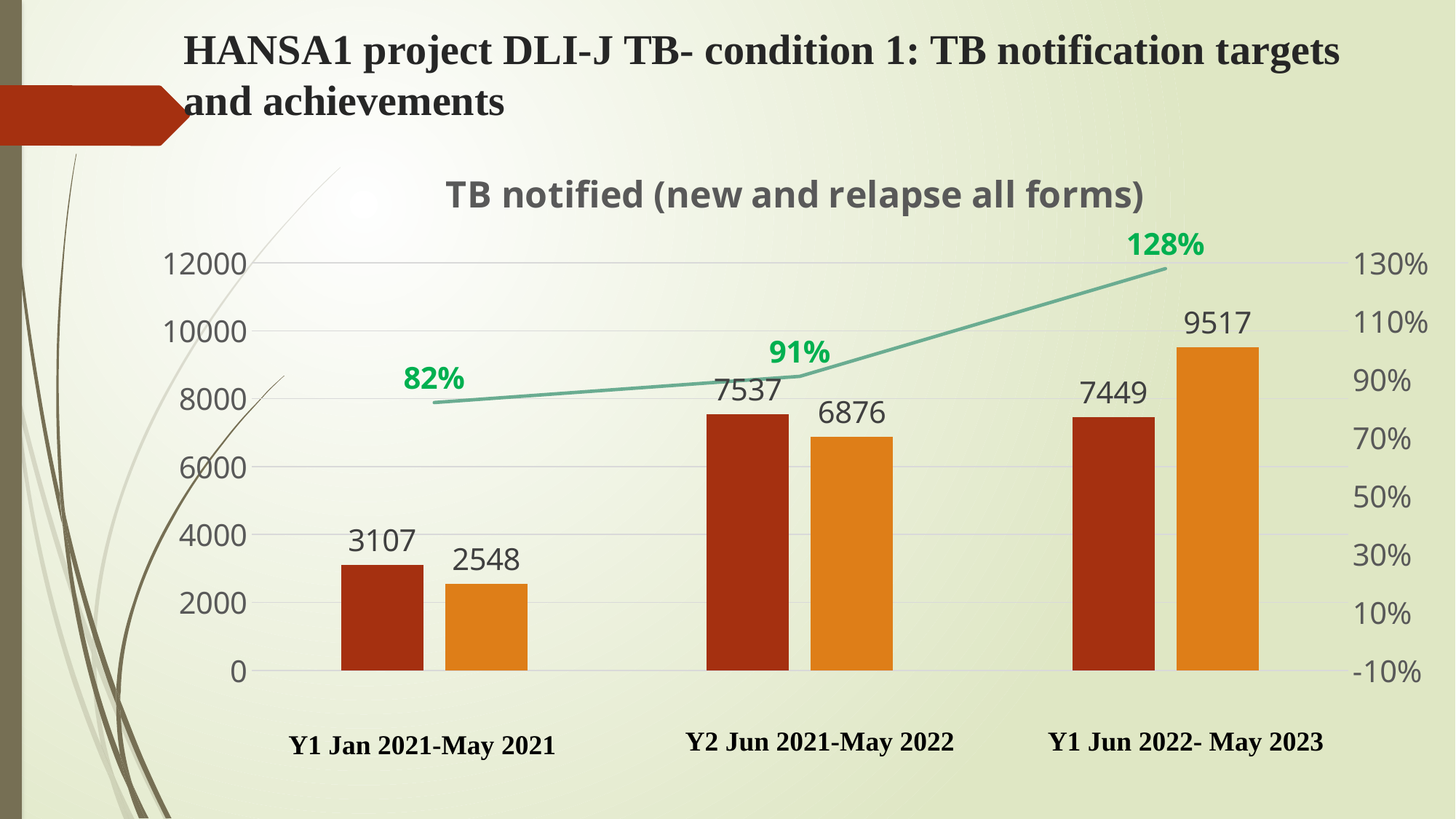
What is the value of the orange bar for Y1 Jun 2022- May 2023? 9517 What is the difference between the dark red bar and the orange bar for Y1 Jan 2021-May 2021? 559 What is the value of the orange bar for Y2 Jun 2021-May 2022? 6876 Which period has the lowest orange bar? Y1 Jan 2021-May 2021 What is the value of the dark red bar for Y1 Jan 2021-May 2021? 3107 What is the title of the chart? TB notified (new and relapse all forms) What percentage is shown on the line for Y2 Jun 2021-May 2022? 91% What is the difference between the orange bar and the dark red bar for Y1 Jun 2022- May 2023? 2068 Which period has the highest percentage on the line? Y1 Jun 2022- May 2023 Which is larger for Y2 Jun 2021-May 2022, the dark red bar or the orange bar? the dark red bar How many periods are shown on the x axis? 3 Does the percentage line rise or fall from left to right? rises